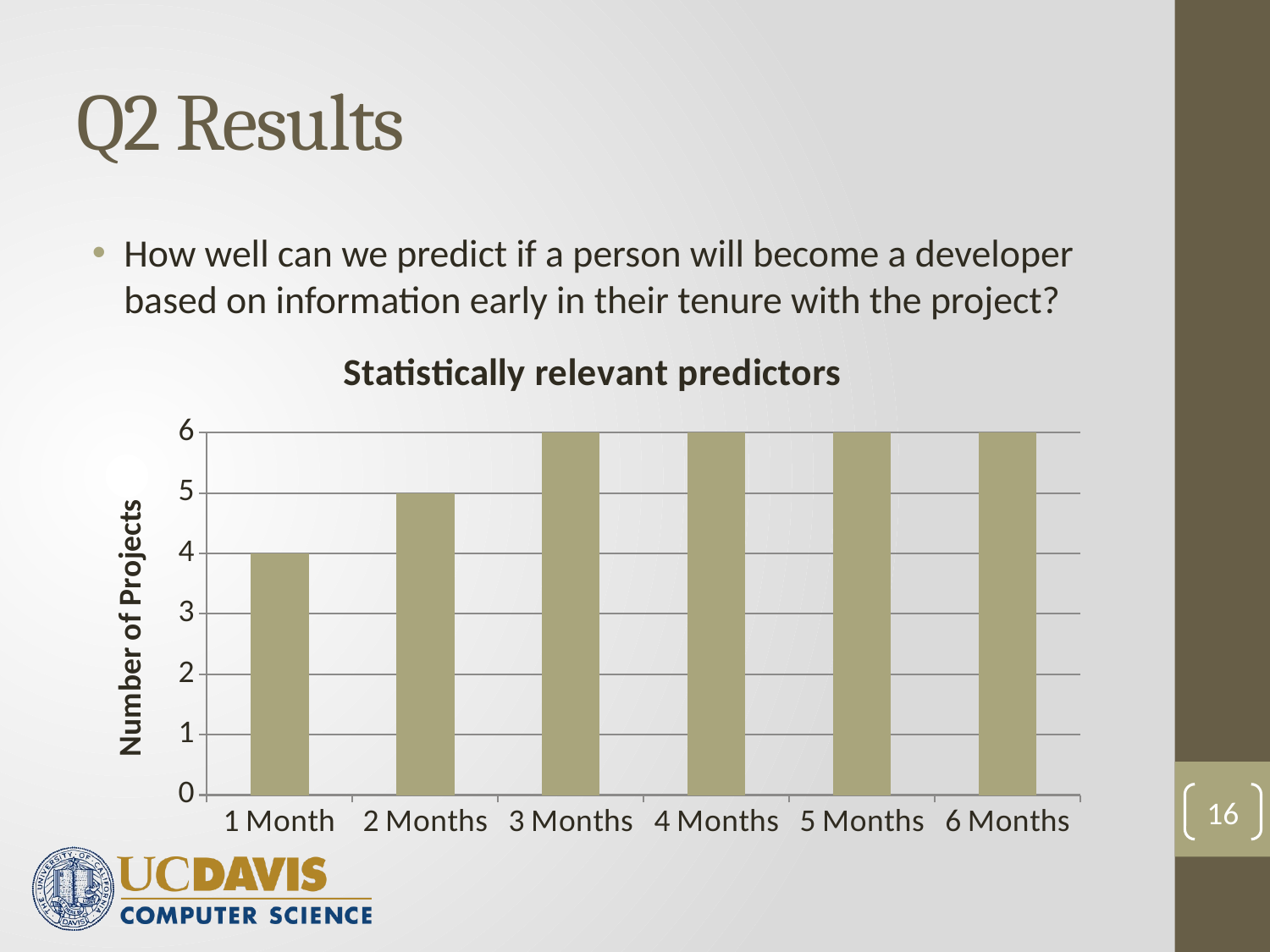
What is the number of projects for 2 Months? 5 Which category has the lowest number of projects? 1 Month What is the title of the chart? Statistically relevant predictors What is the number of projects for 3 Months? 6 What is the label of the vertical axis of the chart? Number of Projects What is the difference in number of projects between 3 Months and 1 Month? 2 Do the values generally rise or fall from 1 Month to 6 Months? Rise How many categories are shown on the x axis of the chart? 6 What is the number of projects for 6 Months? 6 What type of chart is shown on the slide? Bar chart Which has a larger number of projects, 1 Month or 2 Months? 2 Months What is the number of projects for 1 Month? 4